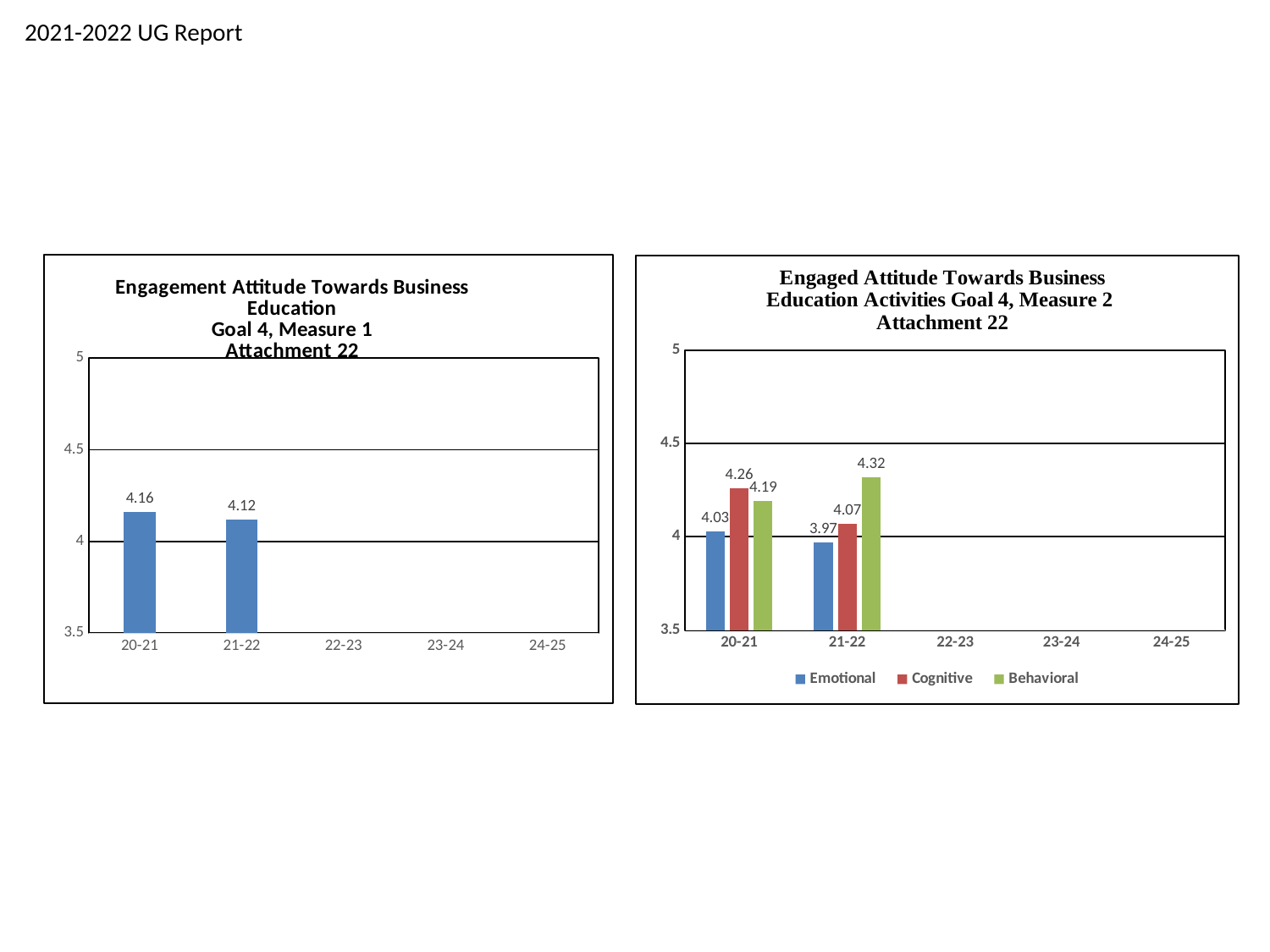
In the right chart (Goal 4, Measure 2), which series has the lowest value in 20-21? Emotional In the left chart (Goal 4, Measure 1), what is the value for 21-22? 4.12 In the right chart (Goal 4, Measure 2), what is the difference between the Behavioral values for 21-22 and 20-21? 0.13 What kind of chart is the left chart (Goal 4, Measure 1)? Bar chart In the left chart (Goal 4, Measure 1), what is the value for 20-21? 4.16 In the right chart (Goal 4, Measure 2), what is the Emotional value for 21-22? 3.97 In the left chart (Goal 4, Measure 1), what is the difference between the 20-21 and 21-22 values? 0.04 In the right chart (Goal 4, Measure 2), is the Emotional value for 21-22 greater or less than 4? less In the right chart (Goal 4, Measure 2), how many series does the legend list? 3 In the left chart (Goal 4, Measure 1), how many year categories are shown on the x axis? 5 In the right chart (Goal 4, Measure 2), what is the Cognitive value for 20-21? 4.26 In the right chart (Goal 4, Measure 2), which series has the highest value in 21-22? Behavioral